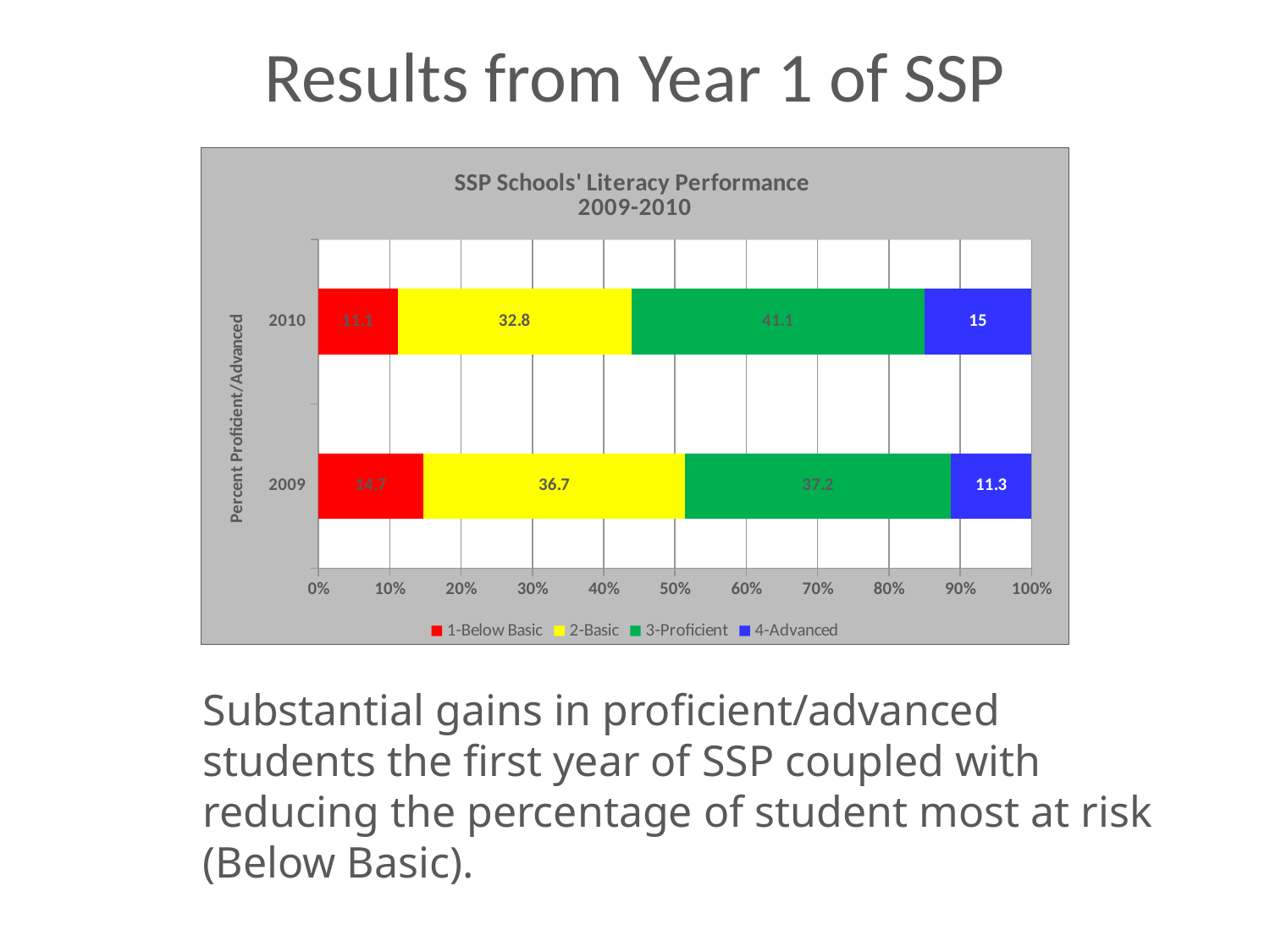
What is the total of the stacked bar for 2009? 99.9 How many years (categories) are shown on the chart? 2 How many series does the legend list? 4 What kind of chart is shown on the slide? Stacked bar chart What is the value for 2-Basic in 2009? 36.7 Which year has the larger 4-Advanced value, 2009 or 2010? 2010 What is the value for 1-Below Basic in 2009? 14.7 Which series has the largest segment in the 2009 bar? 3-Proficient What is the difference between the 3-Proficient values for 2010 and 2009? 3.9 Which series has the smallest segment in the 2010 bar? 1-Below Basic What is the value for 4-Advanced in 2010? 15 What is the value for 3-Proficient in 2010? 41.1